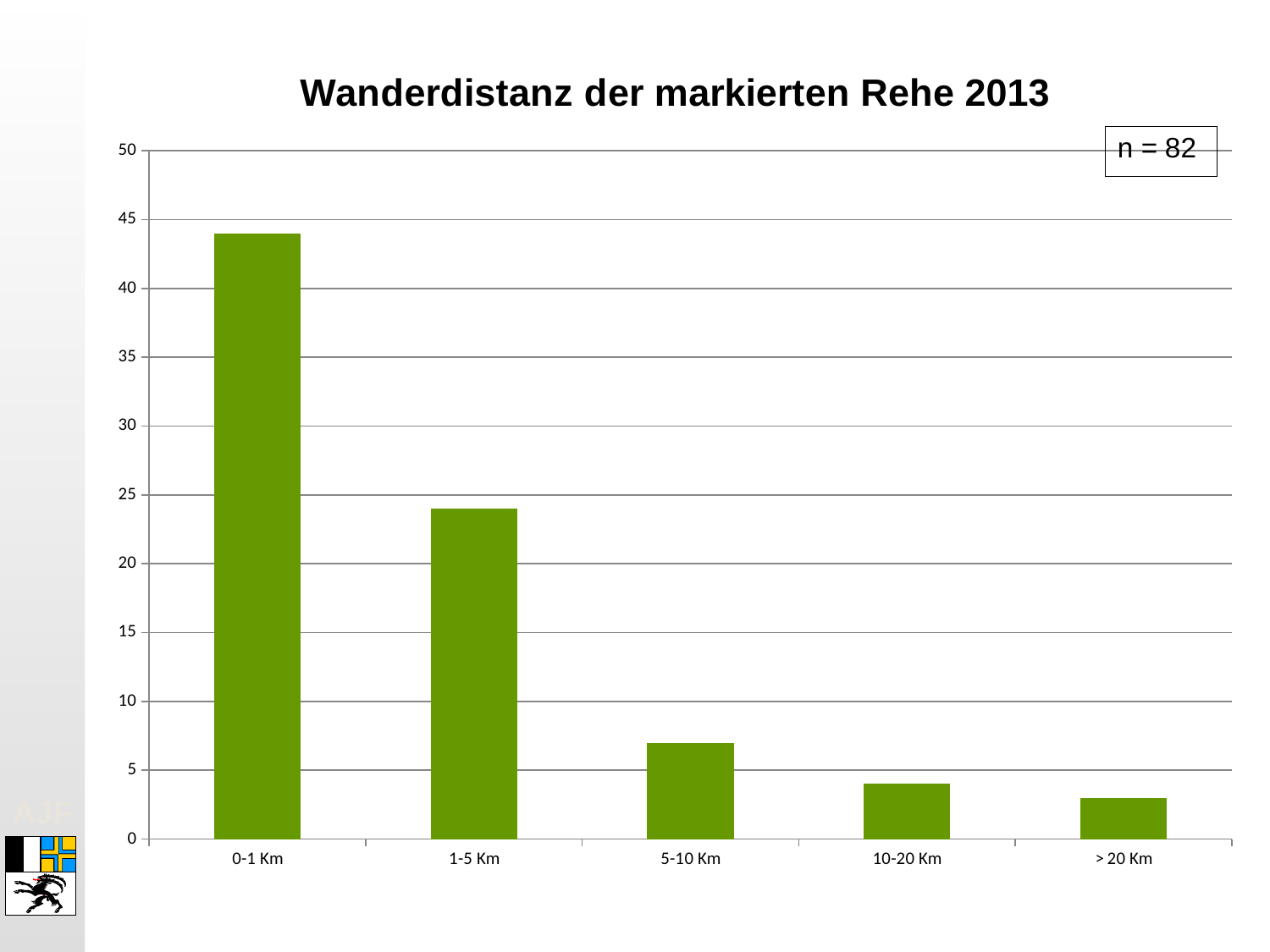
Which distance category has the highest bar? 0-1 Km Is the value for 1-5 Km greater or less than 25? less Which distance category has the lowest bar? > 20 Km What type of chart is shown on the slide? bar chart Which is larger, the value for 1-5 Km or the value for 5-10 Km? 1-5 Km Do the bar values rise or fall from left to right along the x axis? fall Is the value for 0-1 Km greater or less than 40? greater What sample size (n) is stated on the chart? n = 82 How many distance categories are shown on the x axis? 5 Is the value for 5-10 Km greater or less than 5? greater What is the title of the chart? Wanderdistanz der markierten Rehe 2013